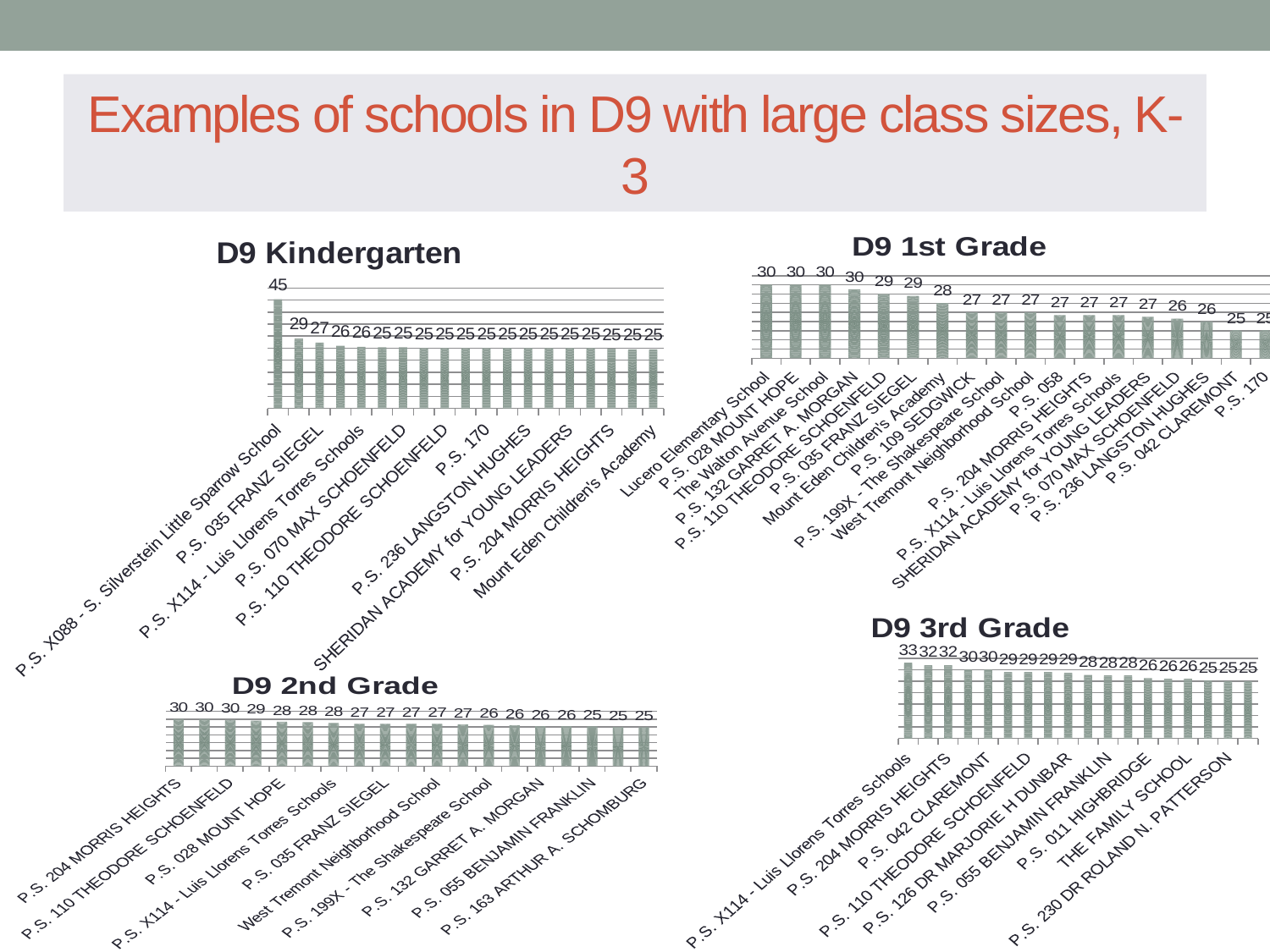
In the D9 1st Grade chart, what is the value for Mount Eden Children's Academy? 28 In the D9 1st Grade chart, what is the value for Lucero Elementary School? 30 In the D9 3rd Grade chart, which school has the highest value? P.S. X114 - Luis Llorens Torres Schools In the D9 2nd Grade chart, what is the value for P.S. 204 MORRIS HEIGHTS? 30 In the D9 Kindergarten chart, what is the difference between the highest value and the second-highest value? 16 In the D9 2nd Grade chart, do the values rise or fall from left to right? Fall In the D9 3rd Grade chart, what is the value for P.S. X114 - Luis Llorens Torres Schools? 33 In the D9 1st Grade chart, what is the value for P.S. 170? 25 In the D9 Kindergarten chart, which school has the highest value? P.S. X088 - S. Silverstein Little Sparrow School In the D9 Kindergarten chart, what is the value for P.S. X088 - S. Silverstein Little Sparrow School? 45 What kind of chart is the D9 3rd Grade chart? Bar chart In the D9 1st Grade chart, which is larger, the value for P.S. 110 THEODORE SCHOENFELD or the value for P.S. 236 LANGSTON HUGHES? P.S. 110 THEODORE SCHOENFELD